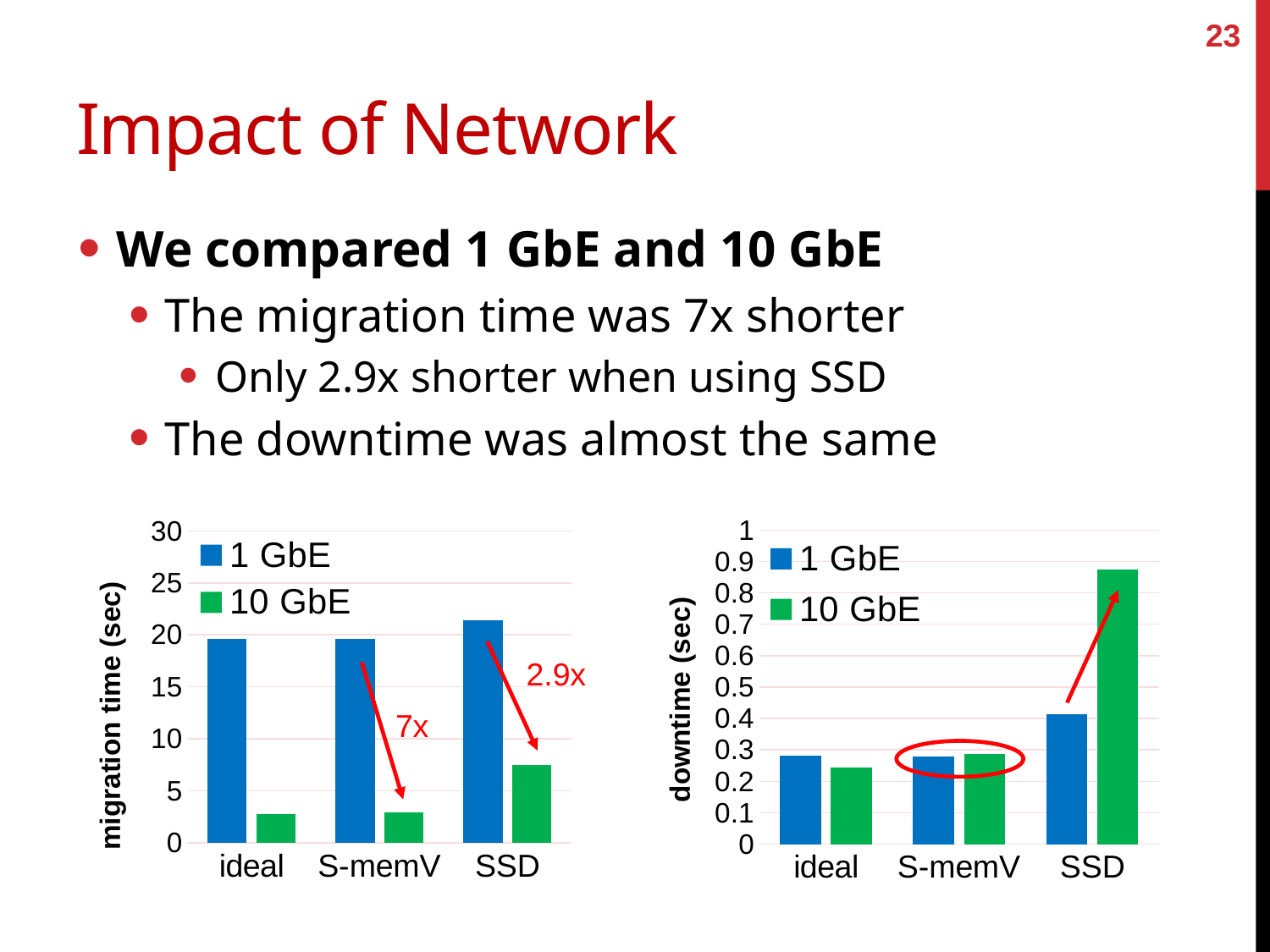
In the left chart (migration time), which category has the highest 10 GbE value? SSD In the left chart (migration time), is the 10 GbE value for ideal greater or less than 5? less In the right chart (downtime), is the 10 GbE value for SSD greater or less than 0.8? greater What is the y-axis label of the right chart? downtime (sec) In the right chart (downtime), which category has the highest 10 GbE value? SSD In the right chart (downtime), which is larger for SSD, the 1 GbE value or the 10 GbE value? 10 GbE In the left chart (migration time), which is larger for S-memV, the 1 GbE value or the 10 GbE value? 1 GbE In the left chart (migration time), is the 1 GbE value for SSD greater or less than 20? greater How many series does the legend of the right chart (downtime) list? 2 How many categories are shown on the x axis of the left chart (migration time)? 3 What kind of chart is the left chart (migration time)? bar chart